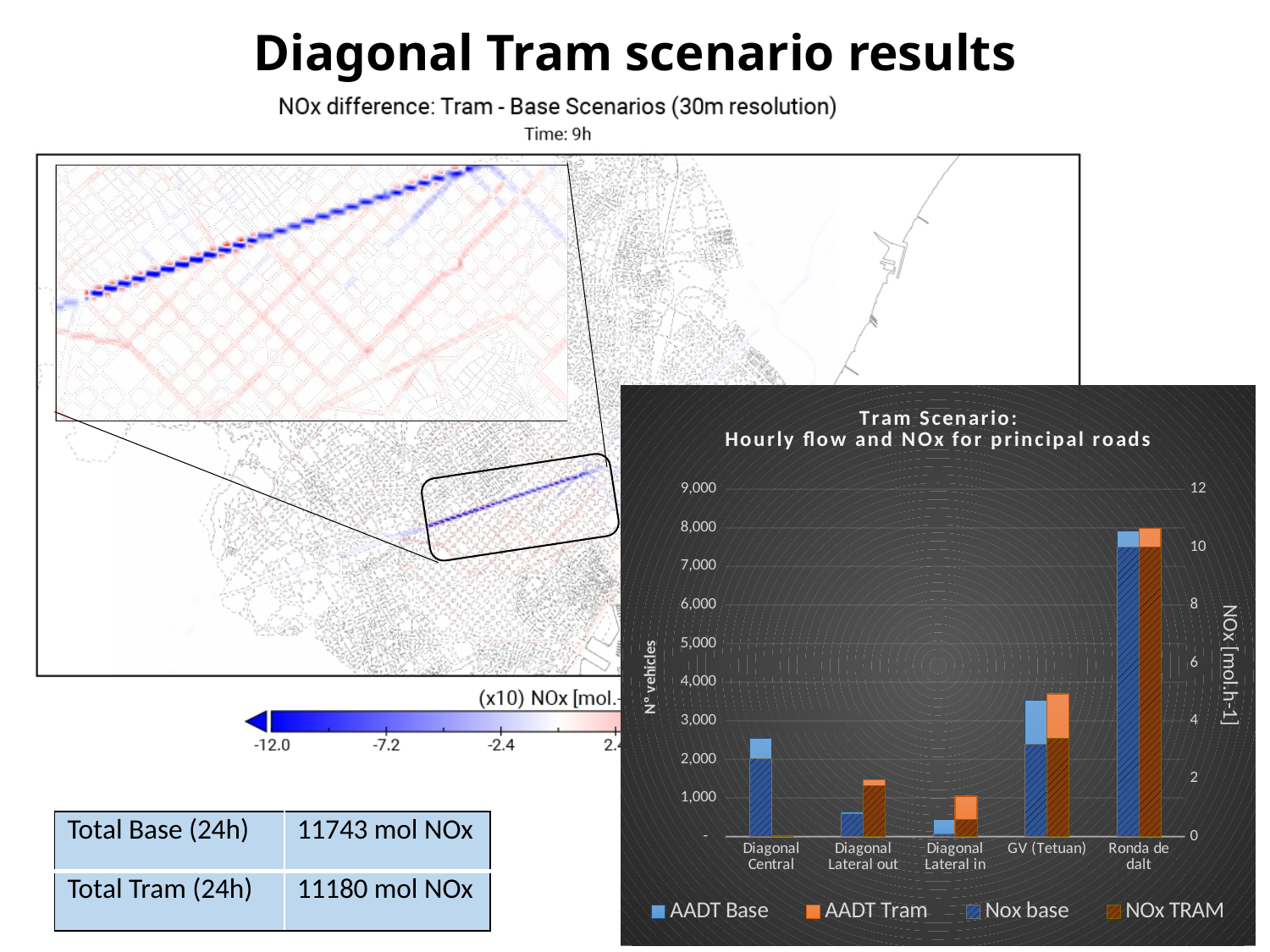
In the 'Tram Scenario' bar chart, for Diagonal Central, which is larger: AADT Base or AADT Tram? AADT Base In the 'Tram Scenario' bar chart, which road has the lowest AADT Tram value? Diagonal Central How many series does the legend of the 'Tram Scenario' bar chart list? 4 In the 'Tram Scenario' bar chart, for Diagonal Lateral out, which is larger: AADT Base or AADT Tram? AADT Tram In the 'Tram Scenario' bar chart, is the AADT Tram value for GV (Tetuan) greater or less than 3,000? greater What kind of chart is the 'Tram Scenario: Hourly flow and NOx for principal roads' chart? bar chart How many road categories are shown on the x axis of the 'Tram Scenario' bar chart? 5 In the 'Tram Scenario' bar chart, is the AADT Base value for Ronda de dalt greater or less than 7,000? greater In the 'Tram Scenario' bar chart, is the AADT Base value for Diagonal Central greater or less than 3,000? less In the 'Tram Scenario' bar chart, which road has the highest AADT Base value? Ronda de dalt What is the label of the right-hand vertical axis of the 'Tram Scenario' bar chart? NOx [mol.h-1]